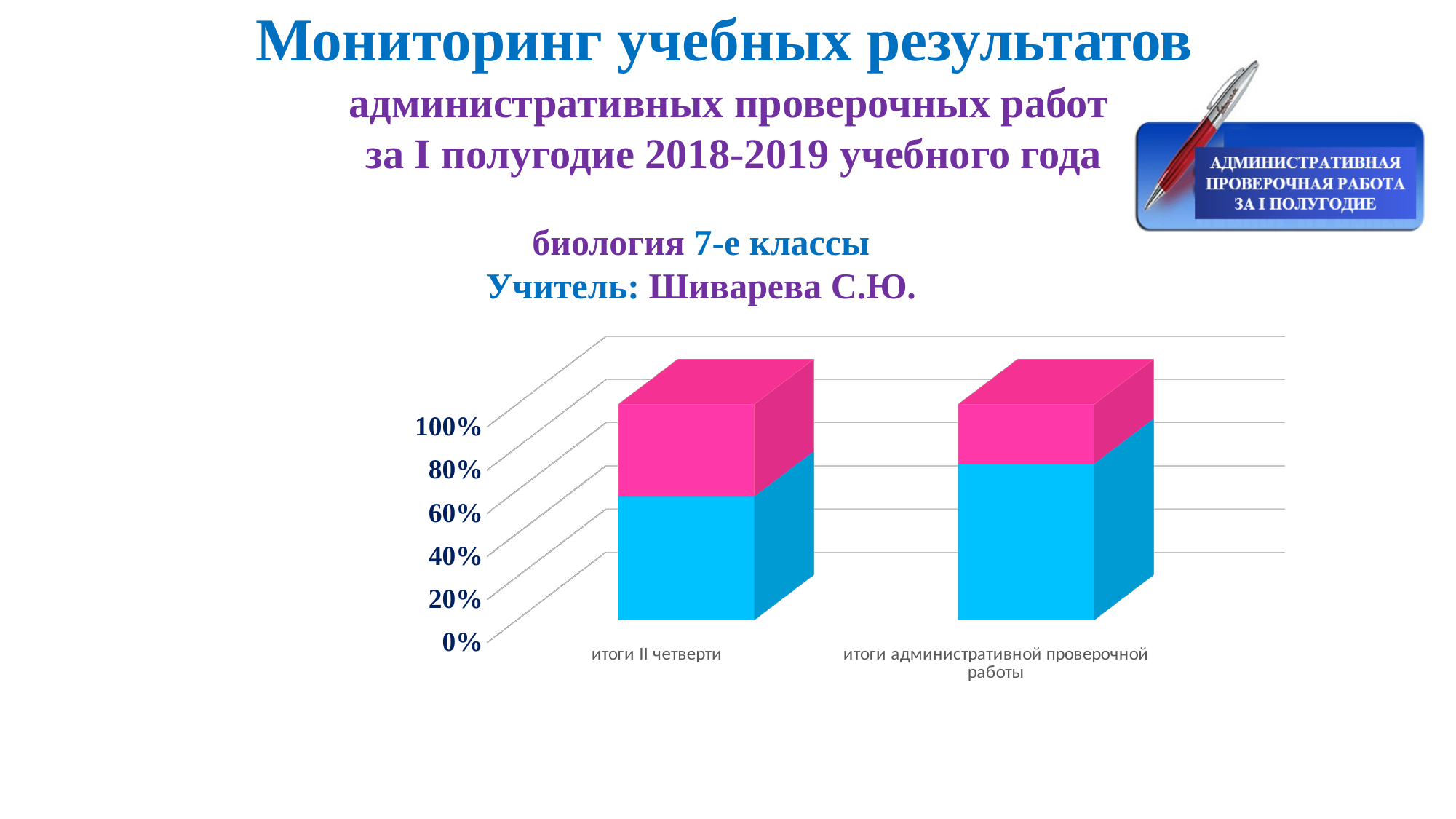
What is the highest value labelled on the vertical axis of the chart? 100% Which category has the larger pink portion: 'итоги II четверти' or 'итоги административной проверочной работы'? итоги II четверти What total does each stacked bar reach on the percentage axis? 100% How many categories are shown on the x axis of the chart? 2 What is the label of the first category on the x axis? итоги II четверти Is the blue portion of the bar for 'итоги административной проверочной работы' greater or less than 60%? greater Is the blue portion of the bar for 'итоги II четверти' greater or less than 40%? greater What kind of chart is shown on the slide? stacked bar chart Does the blue portion rise or fall from 'итоги II четверти' to 'итоги административной проверочной работы'? rise Is the blue portion of the bar for 'итоги II четверти' greater or less than 80%? less Which category has the larger blue portion: 'итоги II четверти' or 'итоги административной проверочной работы'? итоги административной проверочной работы What is the label of the second category on the x axis? итоги административной проверочной работы